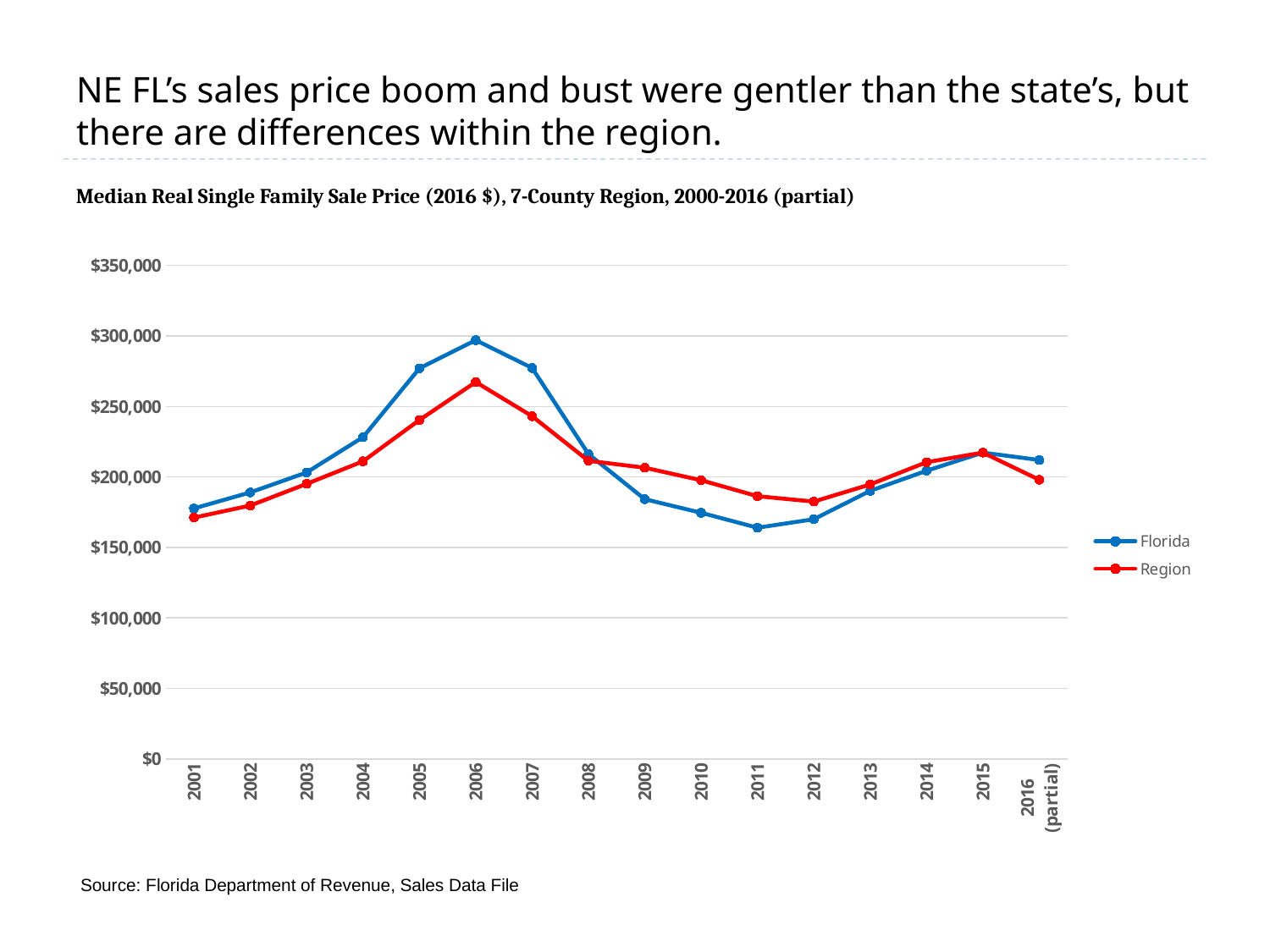
Is the Florida value for 2011 greater or less than $200,000? less In 2006, which series has the higher value, Florida or Region? Florida In 2009, which series has the higher value, Florida or Region? Region In which year does the Florida series reach its lowest value? 2011 What kind of chart is shown on the slide? Line chart How many series does the legend list? 2 Is the Florida value for 2006 greater or less than $250,000? greater In which year does the Florida series reach its highest value? 2006 How many years are plotted along the x axis? 16 In which year does the Region series reach its highest value? 2006 Is the Region value for 2001 greater or less than $200,000? less Does the Florida series rise or fall from 2006 to 2011? Fall